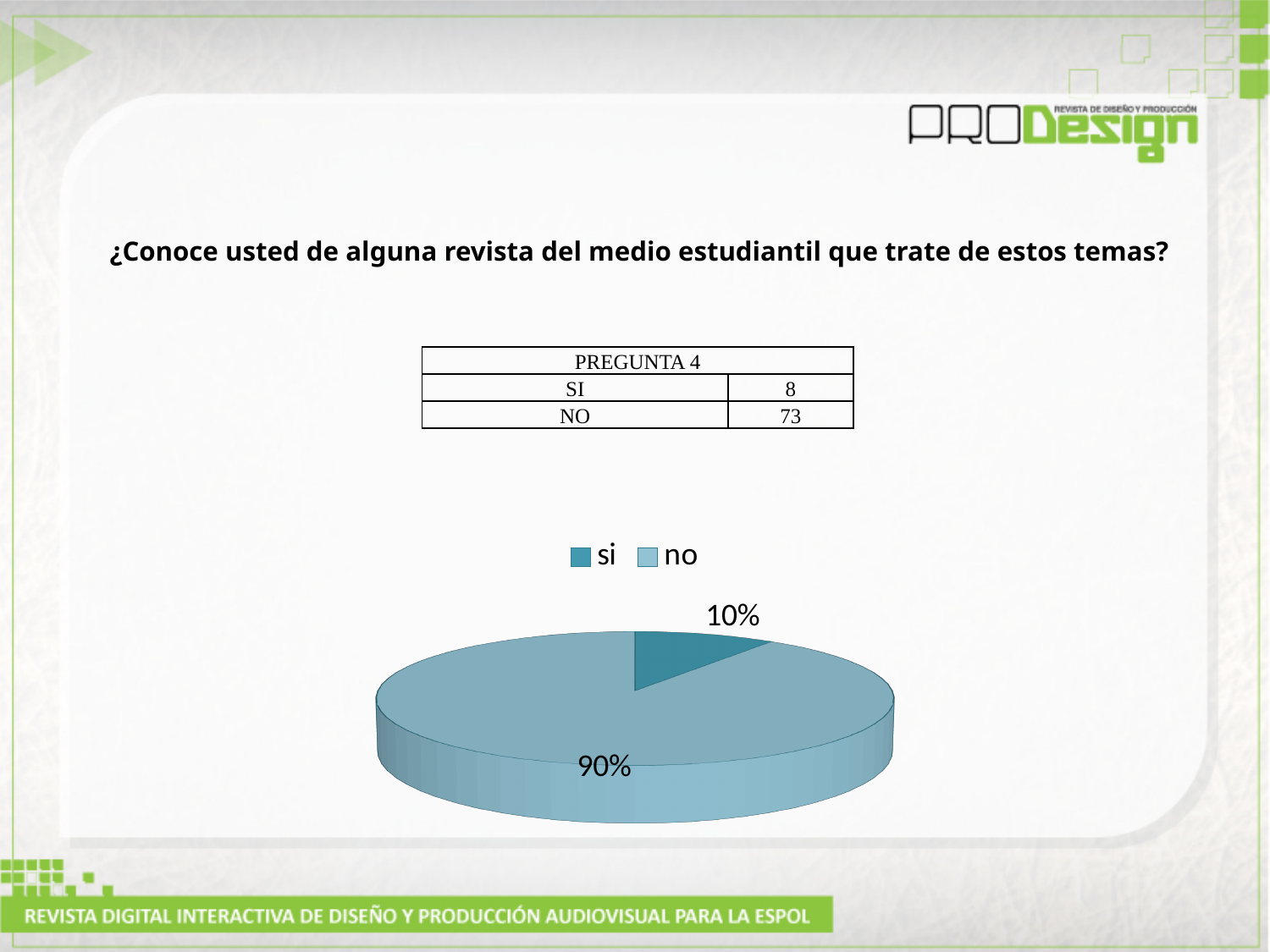
How many entries does the legend of the pie chart list? 2 Which slice is larger, "si" or "no"? no How many slices does the pie chart have? 2 What percentage of the pie chart does the "si" slice represent? 10% Which slice of the pie chart is the smallest? si What are the two legend entries of the pie chart? si, no Which slice of the pie chart is the largest? no What is the difference in percentage points between the "no" slice and the "si" slice? 80 Which legend entry is shown in the darker teal colour? si What percentage of the pie chart does the "no" slice represent? 90% What kind of chart is shown on the slide? pie chart